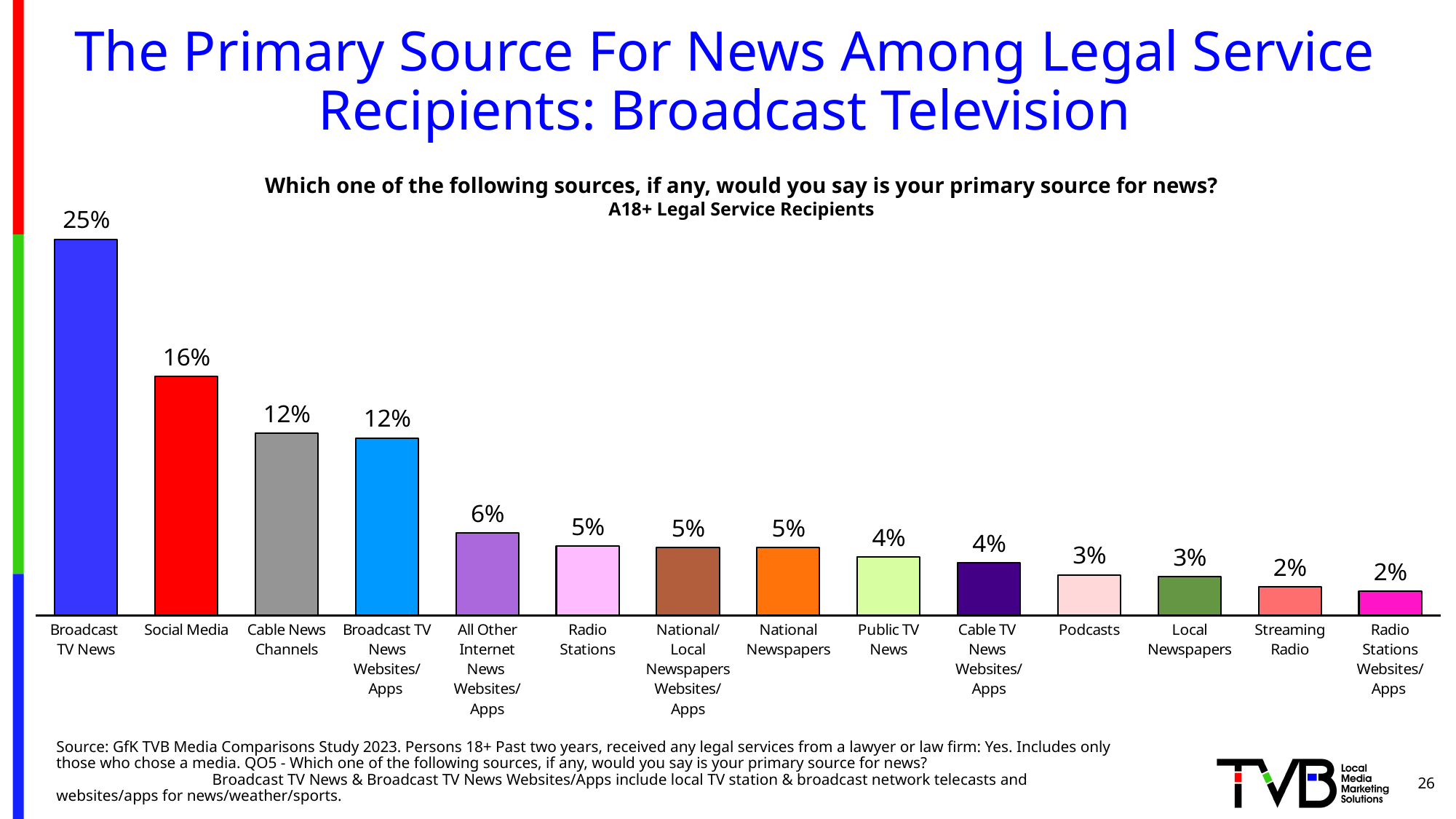
What is the difference between the values for Cable News Channels and Public TV News? 8% What kind of chart is shown on the slide? Bar chart Which category has the highest value in the chart? Broadcast TV News What percentage of legal service recipients say Broadcast TV News is their primary source for news? 25% What is the value shown for National Newspapers? 5% What is the value shown for Social Media? 16% What is the difference between the values for Broadcast TV News and Social Media? 9% What audience is named in the chart's subtitle? A18+ Legal Service Recipients Do the values rise or fall moving from left to right along the x axis? Fall What is the value shown for Podcasts? 3% How many categories are shown in the chart? 14 Which is larger, the value for All Other Internet News Websites/Apps or the value for Streaming Radio? All Other Internet News Websites/Apps